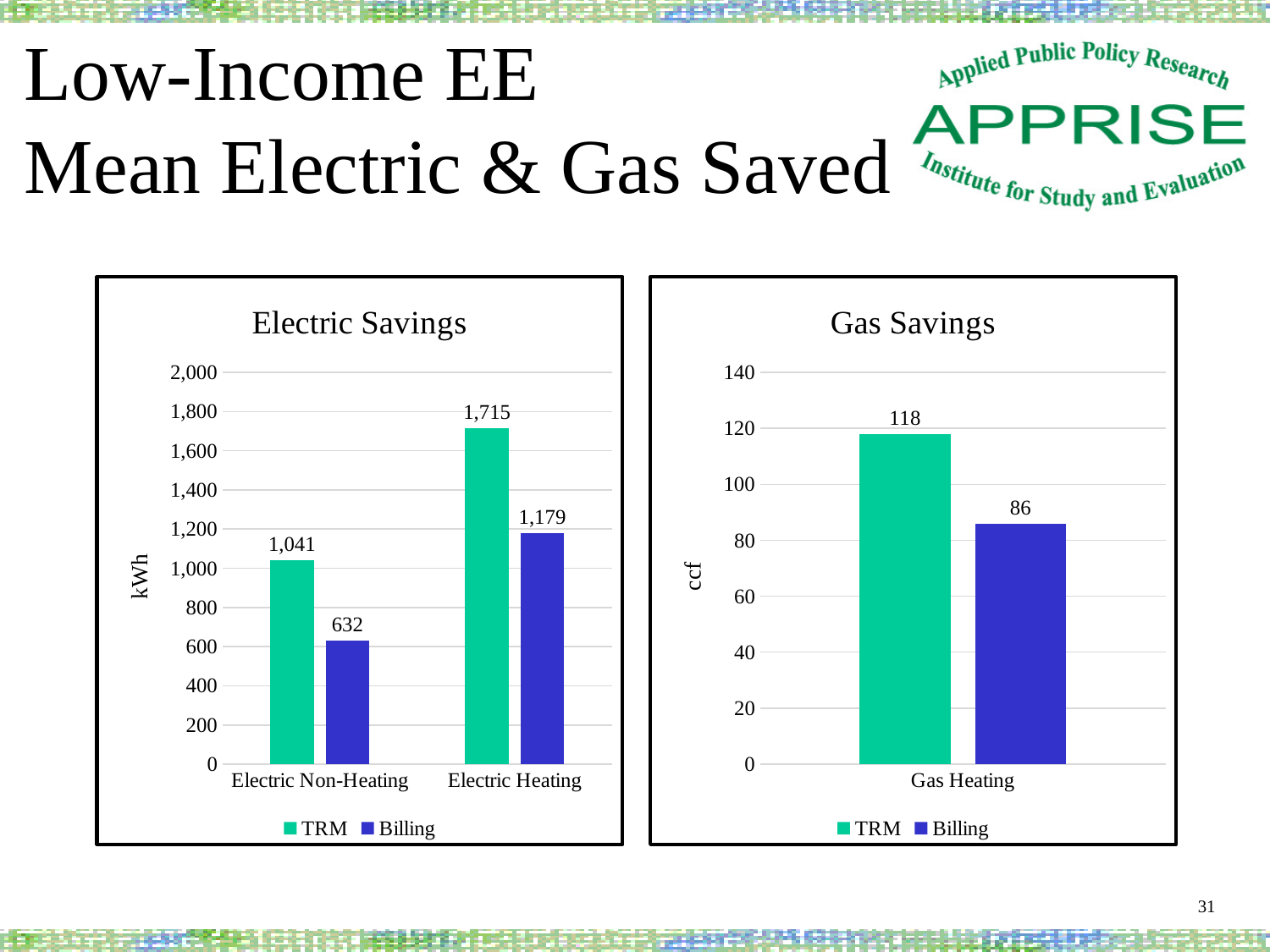
In the Gas Savings chart, is the TRM value for Gas Heating greater or less than 100? greater In the Electric Savings chart, what is the difference between the TRM and Billing values for Electric Non-Heating? 409 In the Electric Savings chart, what is the Billing value for Electric Heating? 1,179 In the Electric Savings chart, which bar has the lowest value? Billing for Electric Non-Heating How many series does the legend of the Gas Savings chart list? 2 What type of chart is the Gas Savings chart? Bar chart In the Electric Savings chart, which is larger for Electric Heating, TRM or Billing? TRM How many categories are shown on the x axis of the Electric Savings chart? 2 In the Gas Savings chart, what is the Billing value for Gas Heating? 86 In the Electric Savings chart, what is the TRM value for Electric Non-Heating? 1,041 In the Electric Savings chart, which bar has the highest value? TRM for Electric Heating In the Gas Savings chart, what is the difference between the TRM and Billing values for Gas Heating? 32